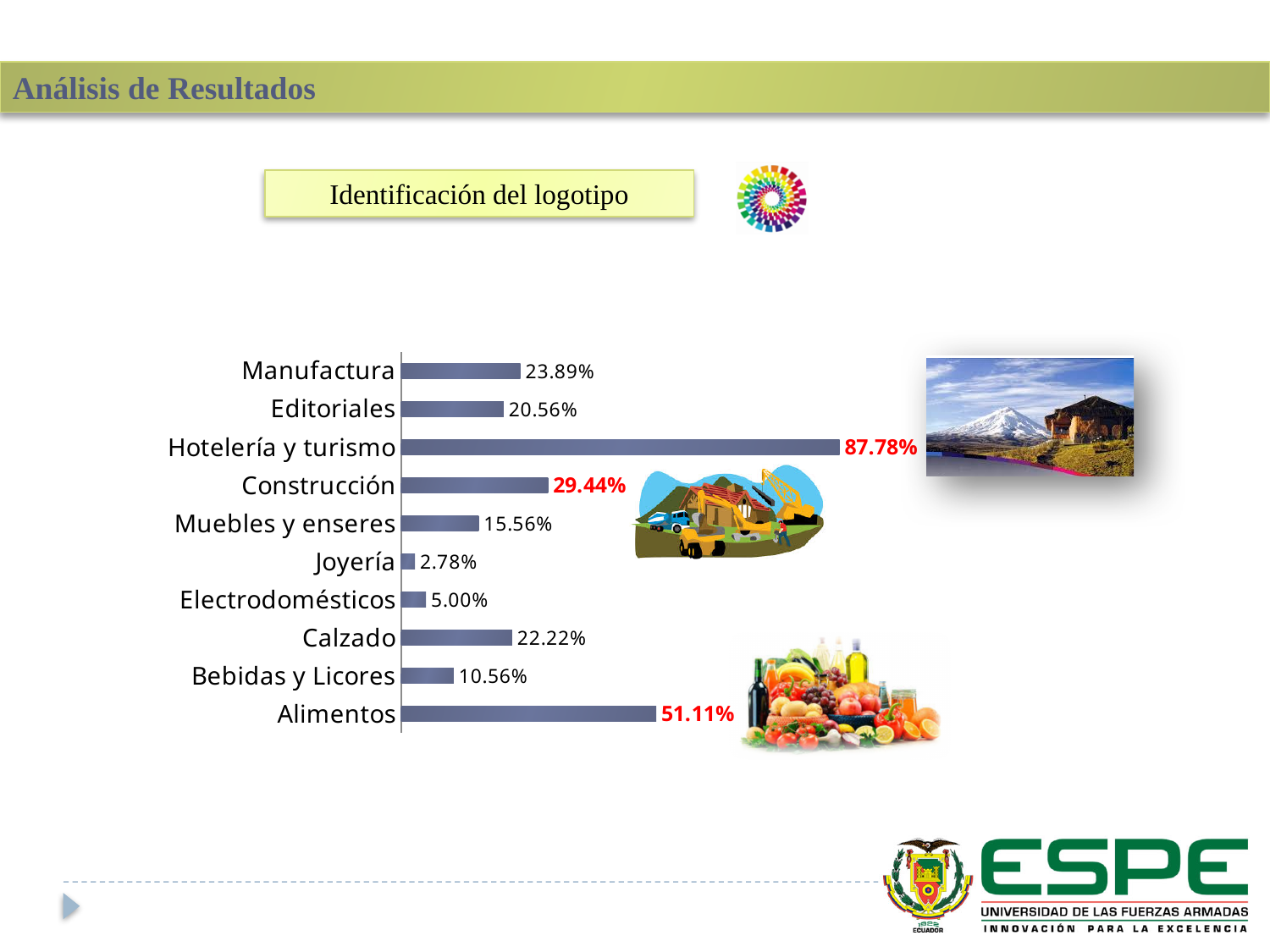
How many categories are shown in the chart? 10 What is the difference between the values for Hotelería y turismo and Alimentos? 36.67% What is the title shown in the box above the chart? Identificación del logotipo What is the value for Alimentos? 51.11% What is the value for Joyería? 2.78% What is the value for Bebidas y Licores? 10.56% Which category has the lowest value? Joyería What is the difference between the values for Construcción and Manufactura? 5.55% Which is larger, the value for Calzado or the value for Editoriales? Calzado Which category has the highest value? Hotelería y turismo What is the value for Hotelería y turismo? 87.78% What kind of chart is shown on the slide? Bar chart